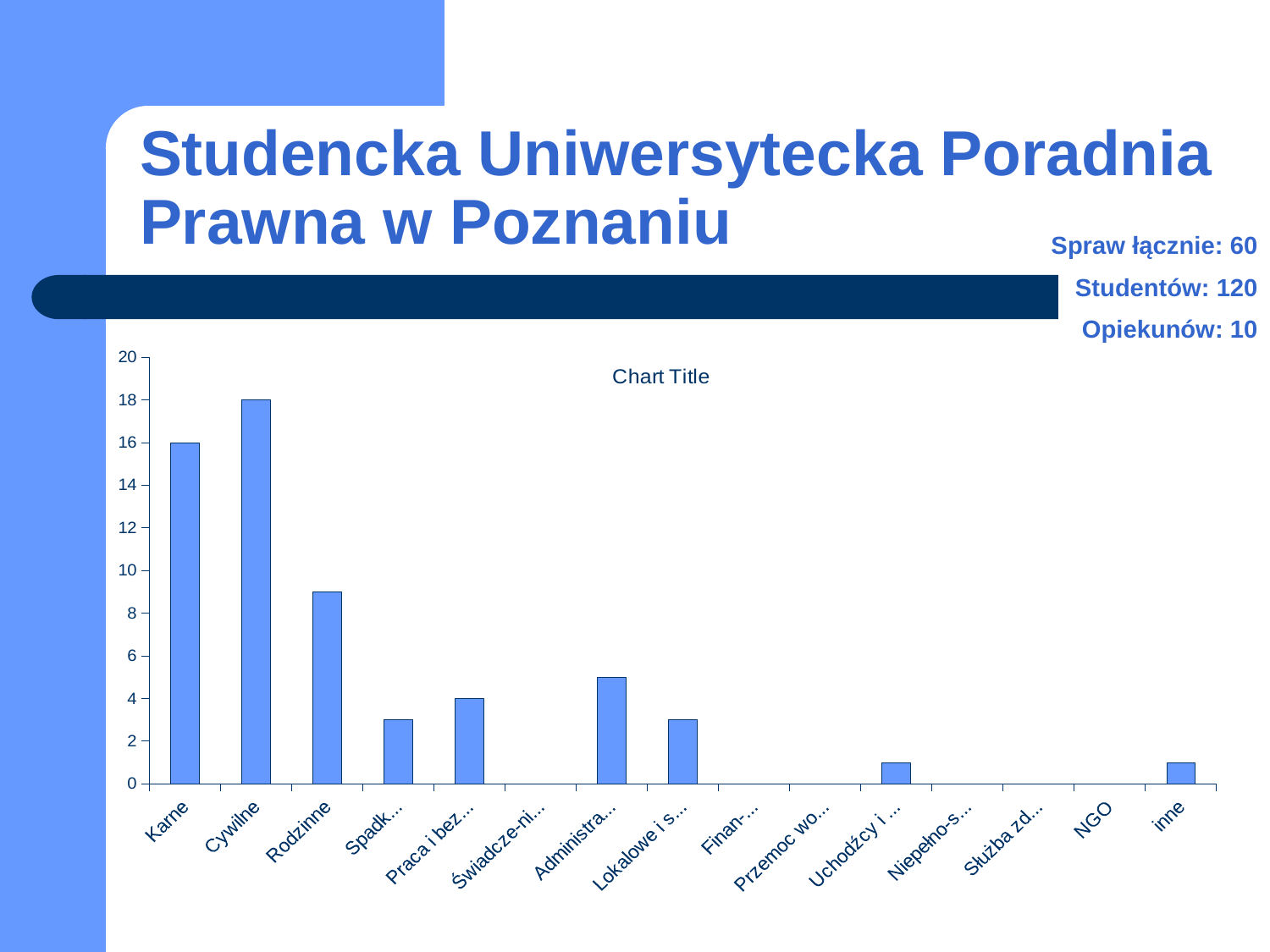
Is the value for Administra... greater or less than 4? greater How many categories are shown on the x axis? 15 Is the value for Rodzinne greater or less than 8? greater What is the difference between the values for Cywilne and Karne? 2 Which category has the highest value? Cywilne What is the title shown on the chart? Chart Title What is the value for Praca i bez...? 4 What is the value for Cywilne? 18 What type of chart is shown on the slide? bar chart Is the value for Spadk... greater or less than 4? less What is the value for Karne? 16 Which is larger, the value for Karne or the value for Rodzinne? Karne